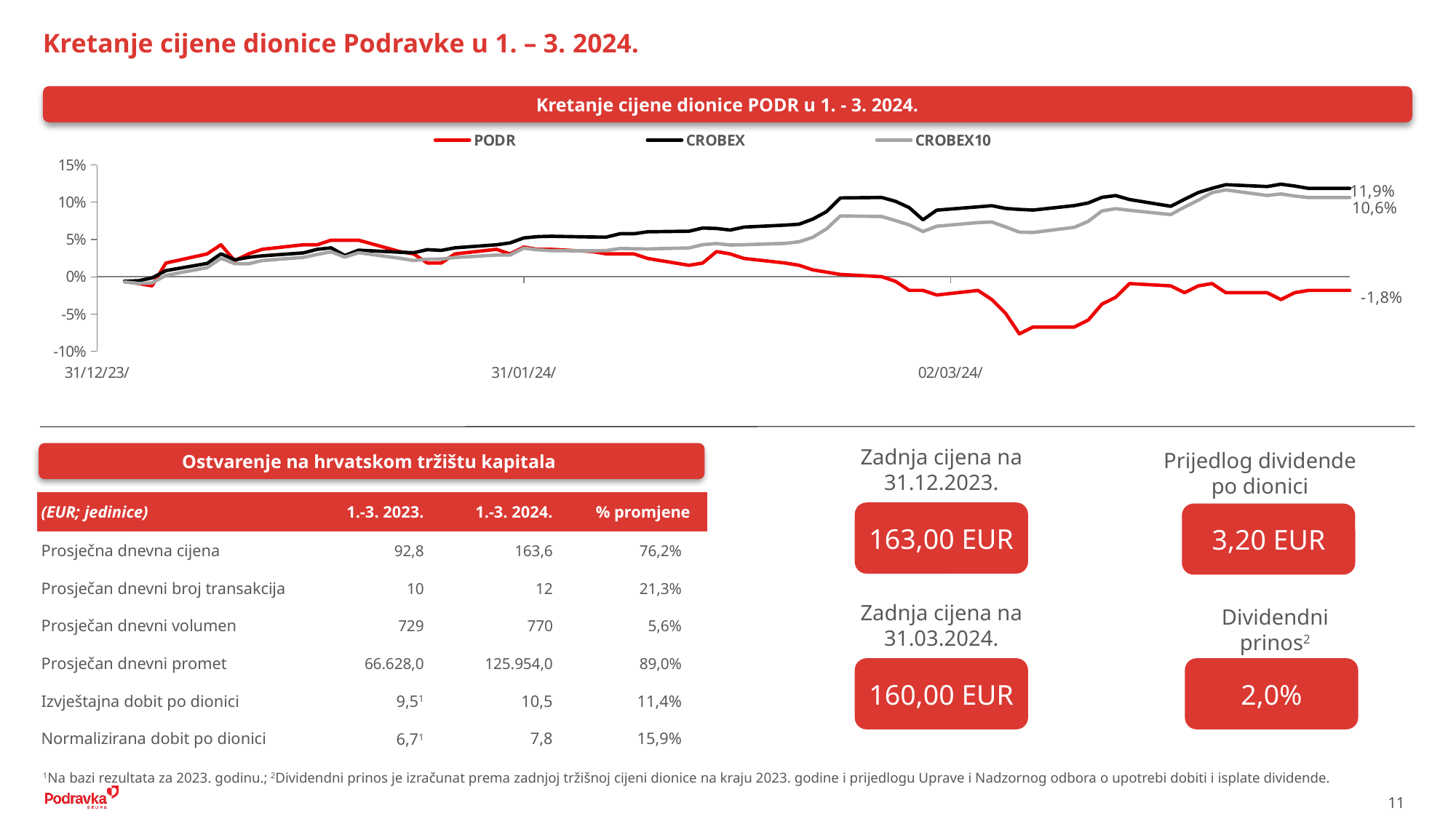
What is the final value shown for CROBEX at the end of the chart? 11,9% What is the final value shown for PODR at the end of the chart? -1,8% What is the difference between the final values of CROBEX and CROBEX10? 1,3 percentage points Which series ends the period with the lowest value? PODR At the end of the chart, which is larger: the value for PODR or the value for CROBEX10? CROBEX10 What type of chart is shown on the slide? line chart What is the final value shown for CROBEX10 at the end of the chart? 10,6% Which series ends the period with the highest value? CROBEX What colour is the PODR line in the chart? red Does the CROBEX line generally rise or fall from 31/12/23 to the end of the chart? rise Is the lowest point of the PODR line greater or less than -5%? less How many series does the chart legend list? 3